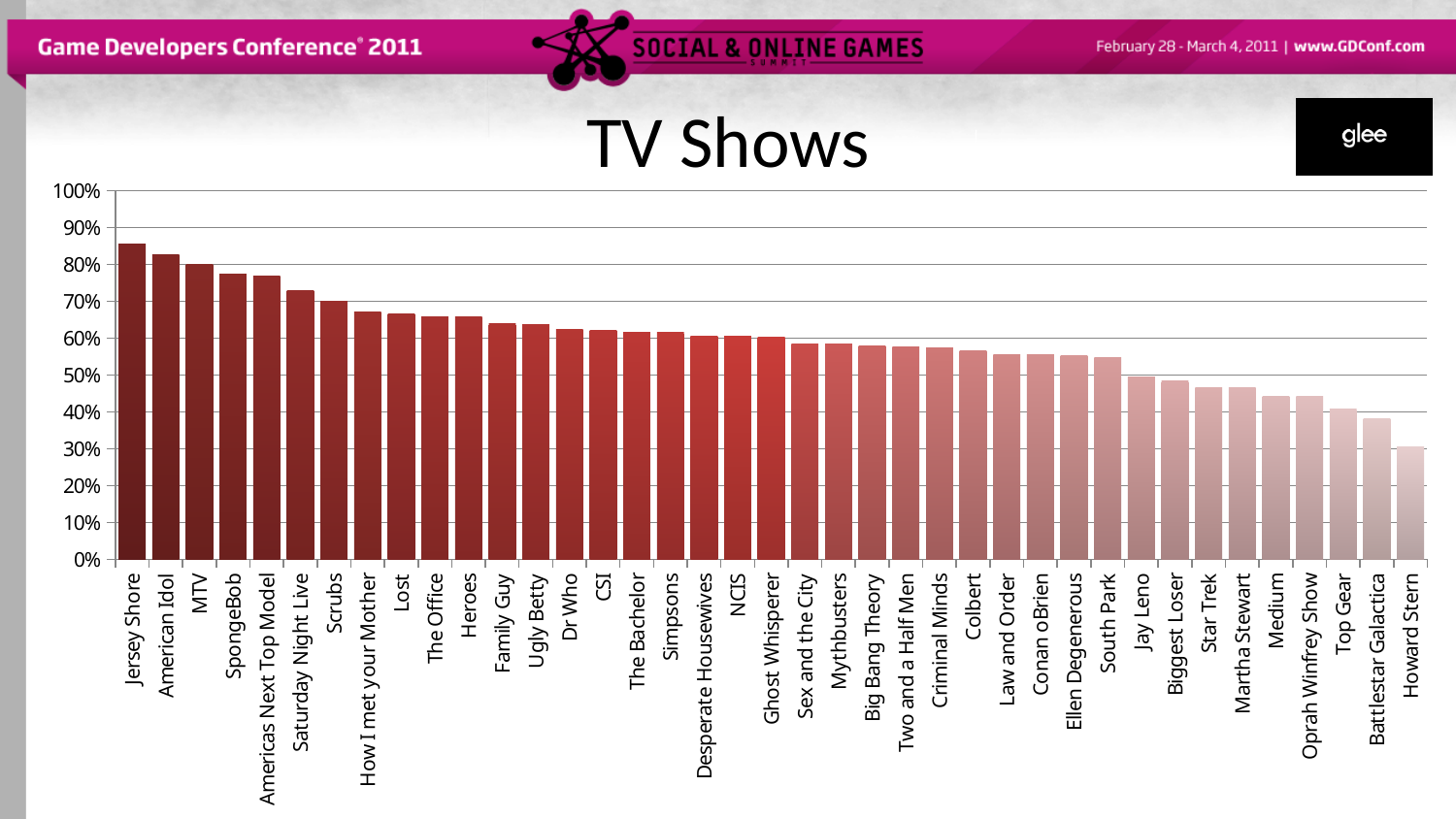
Which has the larger value, Jay Leno or Lost? Lost How many TV shows are plotted in the chart? 39 Which TV show has the highest value in the chart? Jersey Shore Which TV show has the lowest value in the chart? Howard Stern Is the value for Battlestar Galactica greater or less than 40%? less Is the value for Jersey Shore greater or less than 80%? greater Do the values rise or fall moving from left to right along the x axis? fall Is the value for Medium greater or less than 50%? less What kind of chart is shown on the slide? bar chart What is the title of the chart? TV Shows Which has the larger value, MTV or Top Gear? MTV